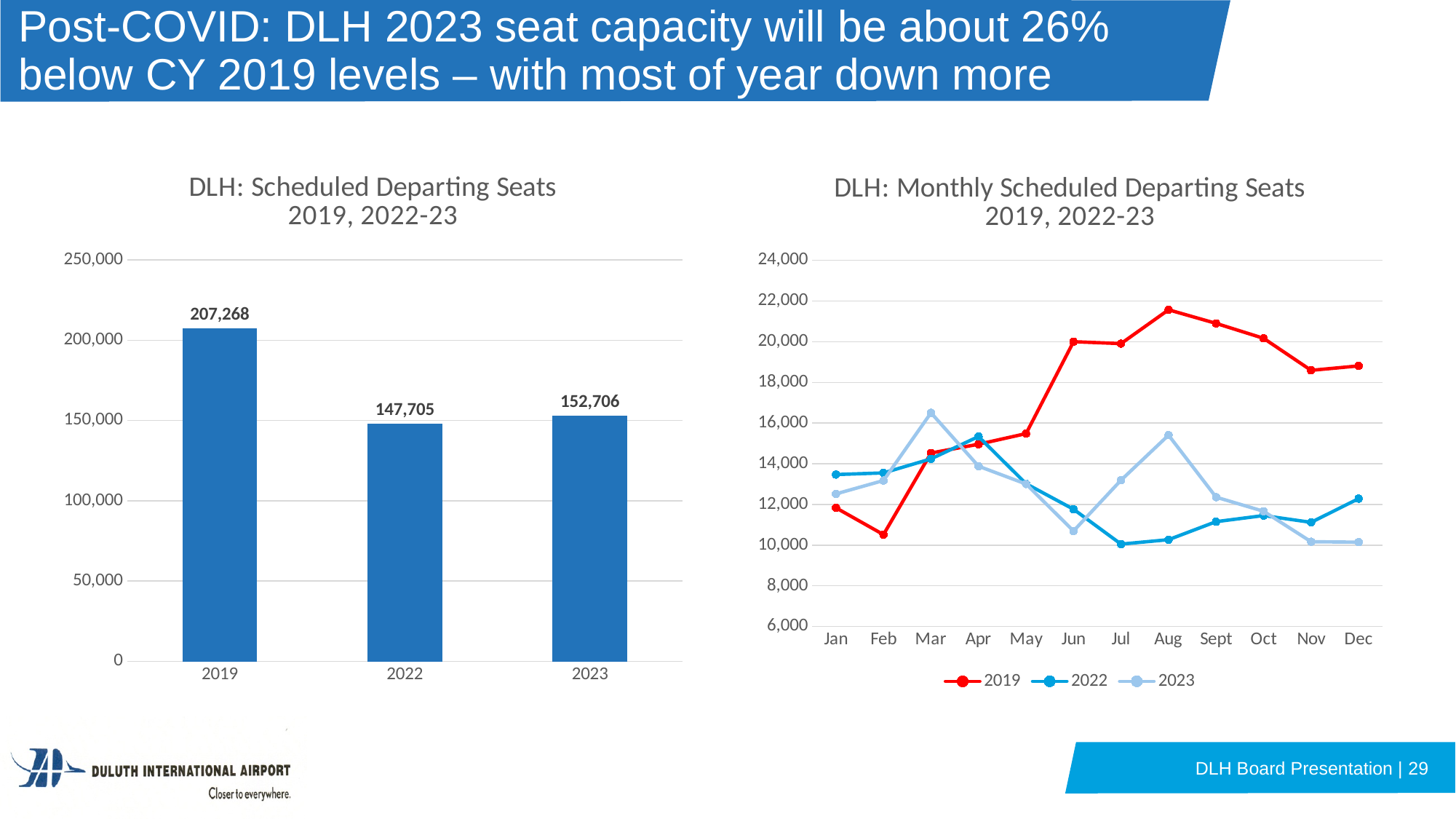
In the chart 'DLH: Scheduled Departing Seats 2019, 2022-23', how much higher is the 2023 value than the 2022 value? 5,001 What kind of chart is 'DLH: Scheduled Departing Seats 2019, 2022-23'? Bar chart How many series does the legend list in the chart 'DLH: Monthly Scheduled Departing Seats 2019, 2022-23'? 3 In the chart 'DLH: Scheduled Departing Seats 2019, 2022-23', what is the difference between the 2019 and 2023 values? 54,562 In the chart 'DLH: Scheduled Departing Seats 2019, 2022-23', what is the value for 2019? 207,268 How many bars are shown in the chart 'DLH: Scheduled Departing Seats 2019, 2022-23'? 3 In the chart 'DLH: Scheduled Departing Seats 2019, 2022-23', which year has the lowest value? 2022 In the chart 'DLH: Scheduled Departing Seats 2019, 2022-23', which year has the highest value? 2019 In the chart 'DLH: Monthly Scheduled Departing Seats 2019, 2022-23', in which month does the 2019 series reach its highest value? Aug In the chart 'DLH: Monthly Scheduled Departing Seats 2019, 2022-23', is the 2019 value for Aug greater or less than 20,000? greater In the chart 'DLH: Monthly Scheduled Departing Seats 2019, 2022-23', is the 2022 value for Jul greater or less than 12,000? less In the chart 'DLH: Scheduled Departing Seats 2019, 2022-23', what is the value for 2022? 147,705